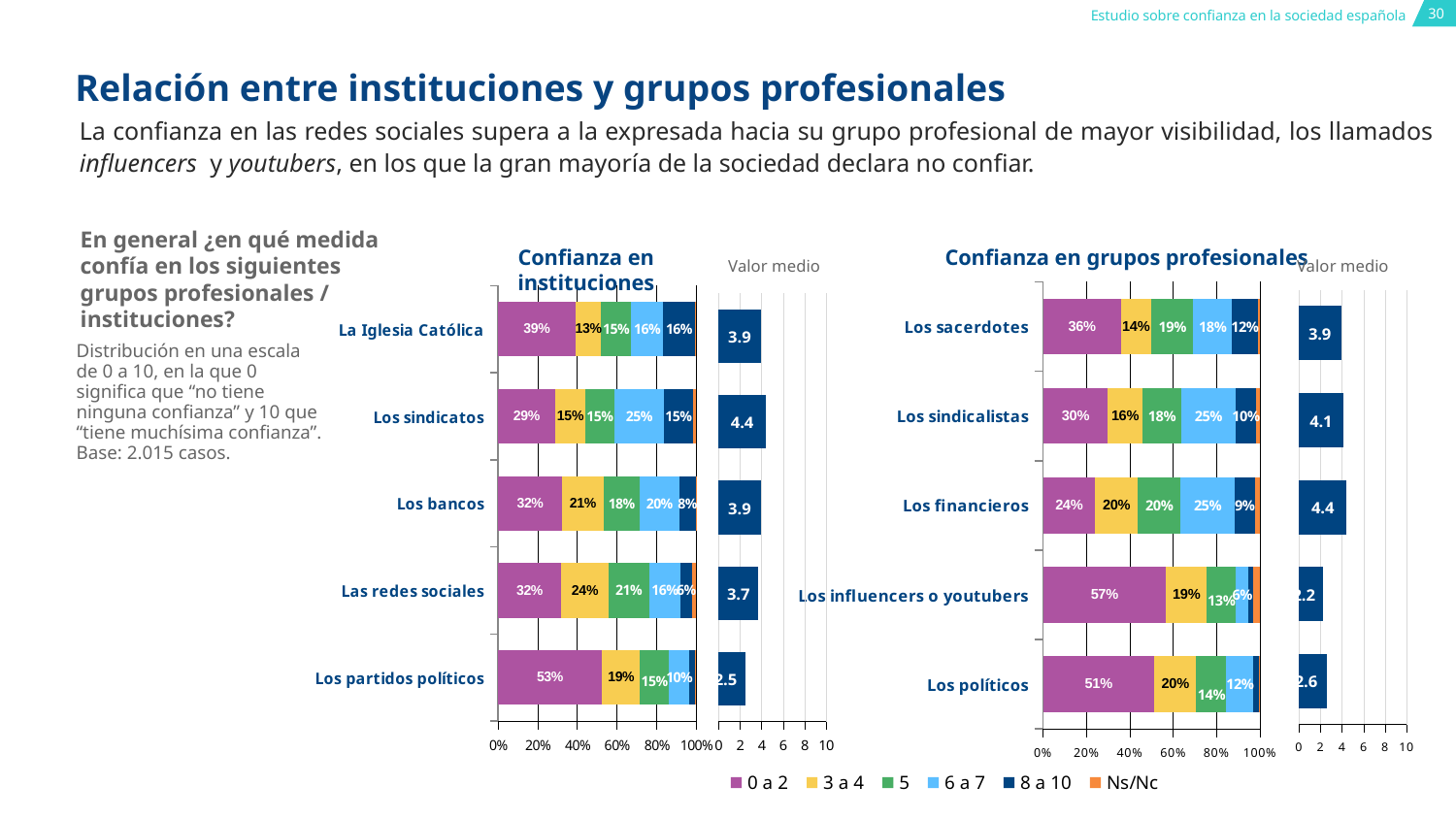
How many series does the shared legend list for the stacked bar charts? 6 How many categories are shown in the 'Confianza en grupos profesionales' chart? 5 In the 'Confianza en instituciones' chart, what percentage gave 'Los sindicatos' a score of 6 a 7? 25% In the 'Confianza en grupos profesionales' chart, what percentage gave 'Los financieros' a score of 8 a 10? 9% In the 'Confianza en instituciones' chart, what is the 'Valor medio' for 'Los partidos políticos'? 2.5 In the 'Confianza en instituciones' chart, which category has the highest 'Valor medio'? Los sindicatos In the 'Confianza en instituciones' chart, what percentage of respondents gave 'La Iglesia Católica' a score of 0 a 2? 39% In the 'Confianza en grupos profesionales' chart, which category has the lowest 'Valor medio'? Los influencers o youtubers In the 'Confianza en grupos profesionales' chart, what is the 'Valor medio' for 'Los financieros'? 4.4 In the 'Confianza en grupos profesionales' chart, which has a larger 0 a 2 percentage: 'Los sacerdotes' or 'Los financieros'? Los sacerdotes In the 'Confianza en instituciones' chart, what is the difference between the 0 a 2 percentages for 'Los partidos políticos' and 'Los bancos'? 21% In the 'Confianza en grupos profesionales' chart, what percentage gave 'Los influencers o youtubers' a score of 0 a 2? 57%